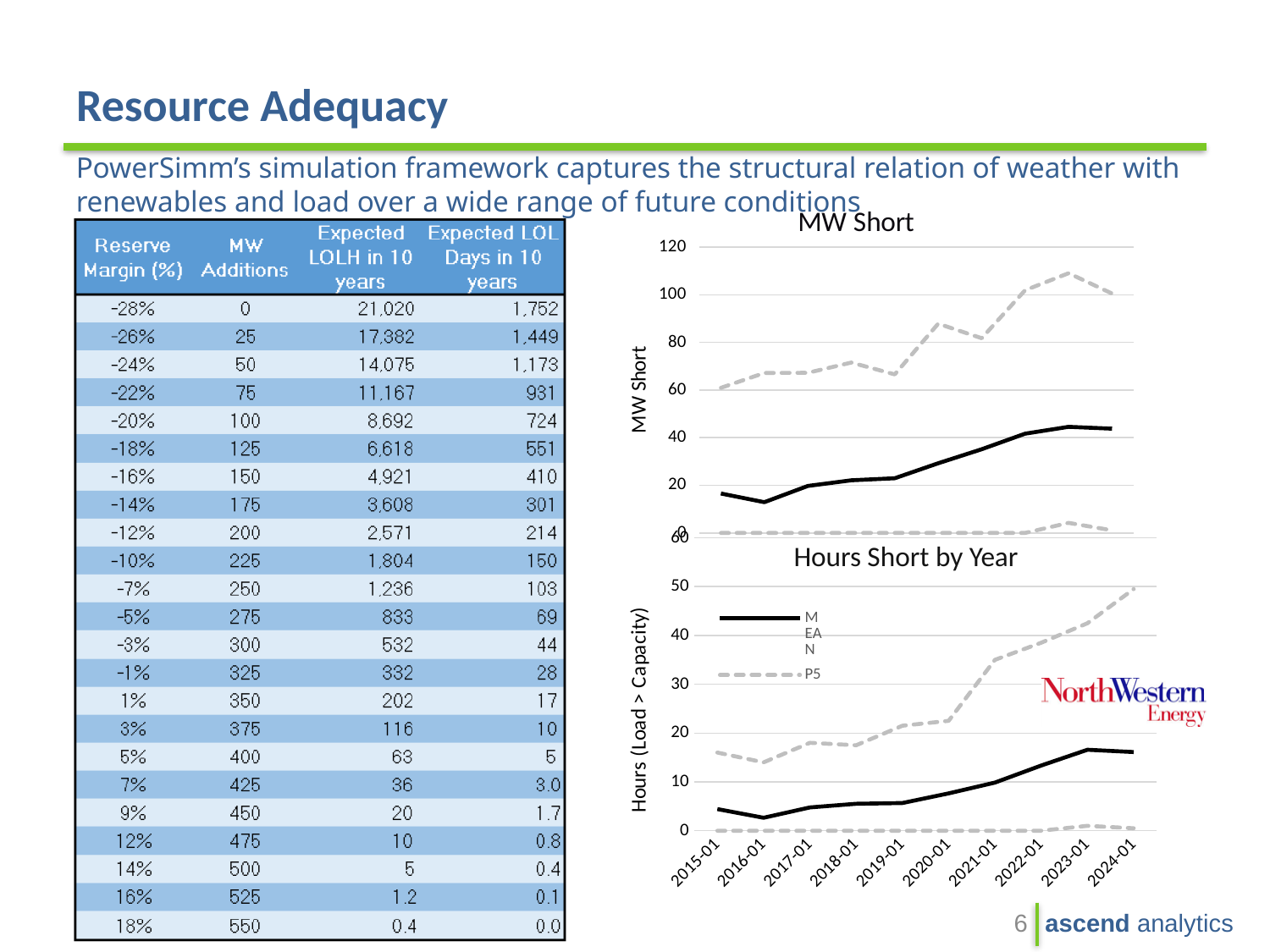
In the "MW Short" chart, is the value of the solid black line at 2015-01 greater or less than 20? less In the "MW Short" chart, is the value of the upper dashed line at 2023-01 greater or less than 100? greater What is the y-axis title of the "Hours Short by Year" chart? Hours (Load > Capacity) In the "MW Short" chart, is the value of the solid black line at 2024-01 greater or less than 40? greater In the "Hours Short by Year" chart, at which x-axis point does the upper dashed line reach its highest value? 2024-01 In the "MW Short" chart, is the solid black line higher at 2015-01 or at 2024-01? 2024-01 In the "MW Short" chart, at which x-axis point is the solid black line at its lowest? 2016-01 What kind of chart is the "MW Short" chart? line chart In the "Hours Short by Year" chart, how many points are labelled along the x axis? 10 In the "MW Short" chart, does the solid black line generally rise or fall from 2015-01 to 2024-01? rise